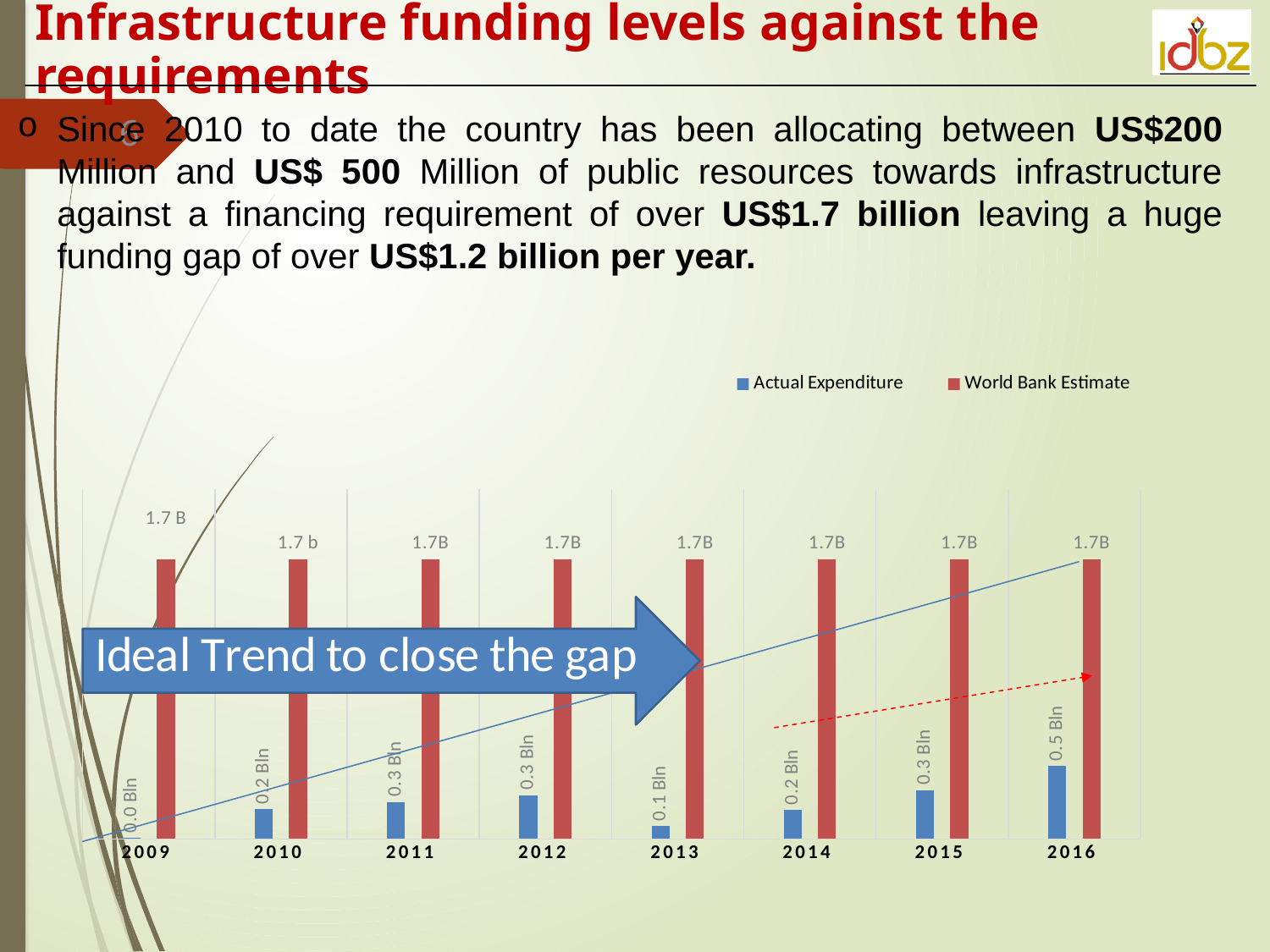
How many years are shown on the x axis of the chart? 8 What is the World Bank Estimate value for 2014? 1.7B Which year has the larger Actual Expenditure, 2011 or 2013? 2011 Does Actual Expenditure rise or fall from 2013 to 2016? Rise What is the Actual Expenditure value for 2013? 0.1 Bln Which year has the highest Actual Expenditure? 2016 What is the difference between the Actual Expenditure in 2016 and in 2010? 0.3 Bln What kind of chart is shown on the slide? Bar chart How many series does the chart legend list? 2 What is the Actual Expenditure value for 2016? 0.5 Bln What colour are the World Bank Estimate bars? Red Which year has the lowest Actual Expenditure? 2009